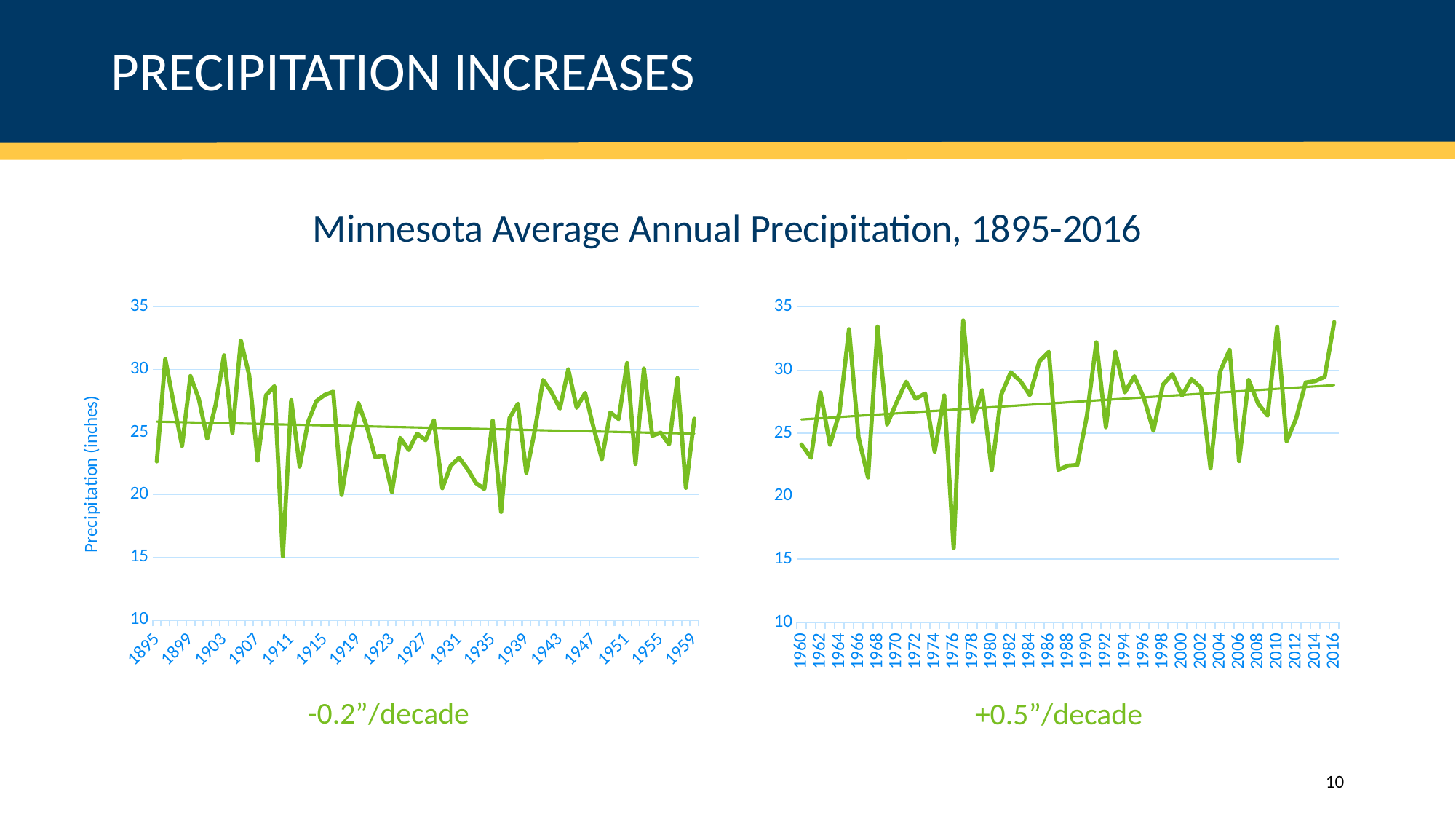
In the right chart (1960-2016), which year has the higher value, 1960 or 2016? 2016 What kind of chart is used on the left to show Minnesota precipitation for 1895-1959? line chart In the right chart (1960-2016), is the value for 1960 greater or less than 25? less In the left chart (1895-1959), does the trend line rise or fall across the years? fall In the left chart (1895-1959), which year has the higher value, 1895 or 1911? 1911 What is the overall title shown above the two charts? Minnesota Average Annual Precipitation, 1895-2016 In the left chart (1895-1959), is the value for 1895 greater or less than 25? less In the left chart (1895-1959), is the value for 1911 greater or less than 20? greater In the right chart (1960-2016), does the trend line rise or fall across the years? rise What is the label on the vertical axis of the left chart? Precipitation (inches)